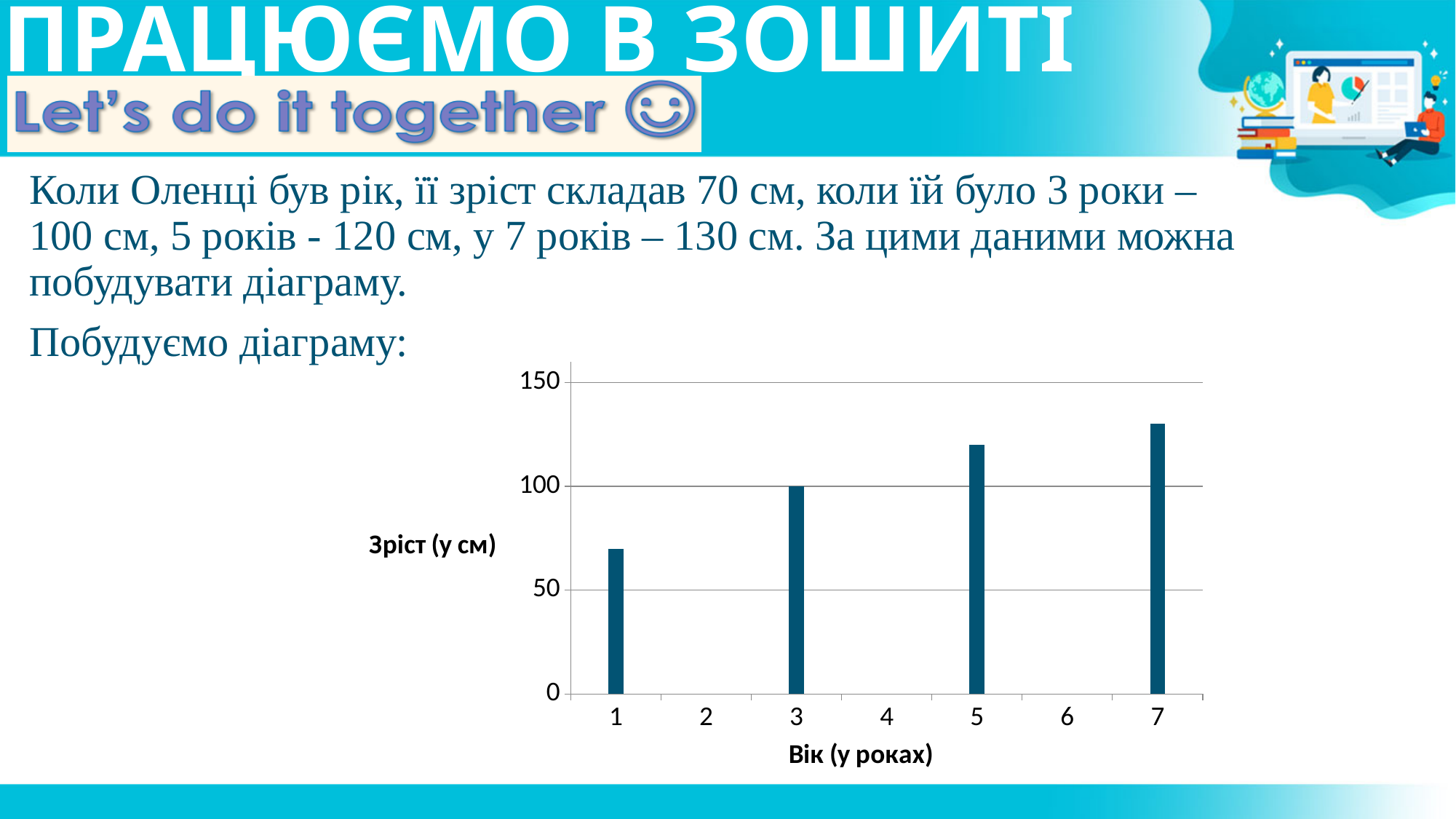
What is the height value for age 1 in the chart? 70 Which age has the lowest bar in the chart? 1 What is the label of the vertical axis of the chart? Зріст (у см) Which age has the highest bar in the chart? 7 What is the height value for age 3 in the chart? 100 What kind of chart is shown on the slide? bar chart Do the bar values rise or fall as age increases along the x axis? rise Is the value for age 1 greater or less than 100? less What is the height value for age 7 in the chart? 130 Is the value for age 5 greater or less than 100? greater How many bars are plotted in the chart? 4 Which is larger, the bar for age 5 or the bar for age 3? age 5